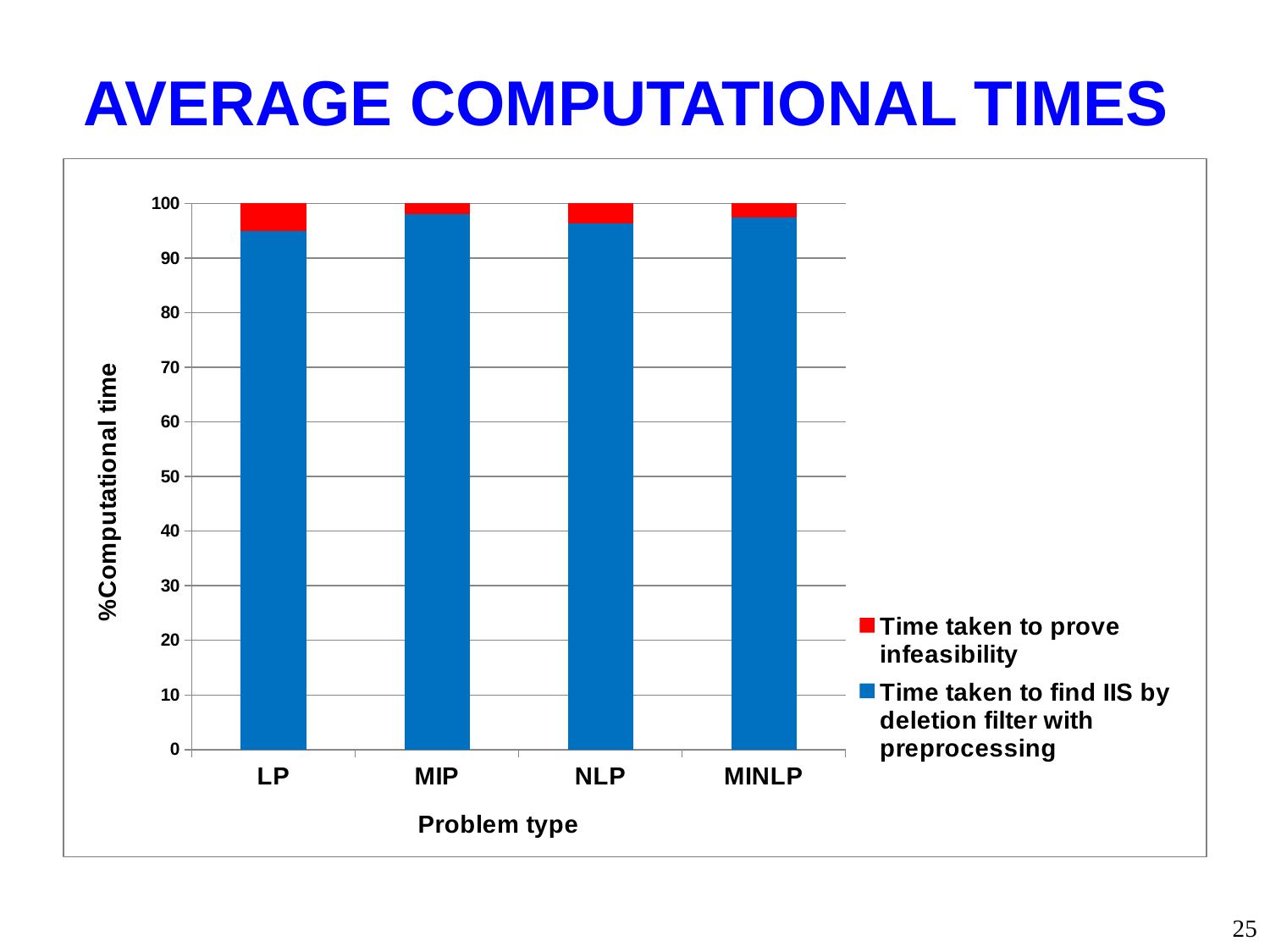
Which is larger, the 'Time taken to prove infeasibility' segment for LP or for MIP? LP Is the value of 'Time taken to prove infeasibility' for MIP greater or less than 10? less Is the value of 'Time taken to find IIS by deletion filter with preprocessing' for LP greater or less than 90? greater Which colour represents 'Time taken to prove infeasibility' in the legend? Red What is the total height of the stacked bar for NLP? 100 What kind of chart is shown on the slide? Stacked bar chart Which problem type has the largest 'Time taken to prove infeasibility' segment? LP Does the 'Time taken to find IIS by deletion filter with preprocessing' segment rise or fall from LP to MIP? rise How many series does the legend list? 2 Which problem type has the smallest 'Time taken to find IIS by deletion filter with preprocessing' segment? LP How many problem types are shown on the x axis? 4 What is the title of the slide containing the chart? AVERAGE COMPUTATIONAL TIMES